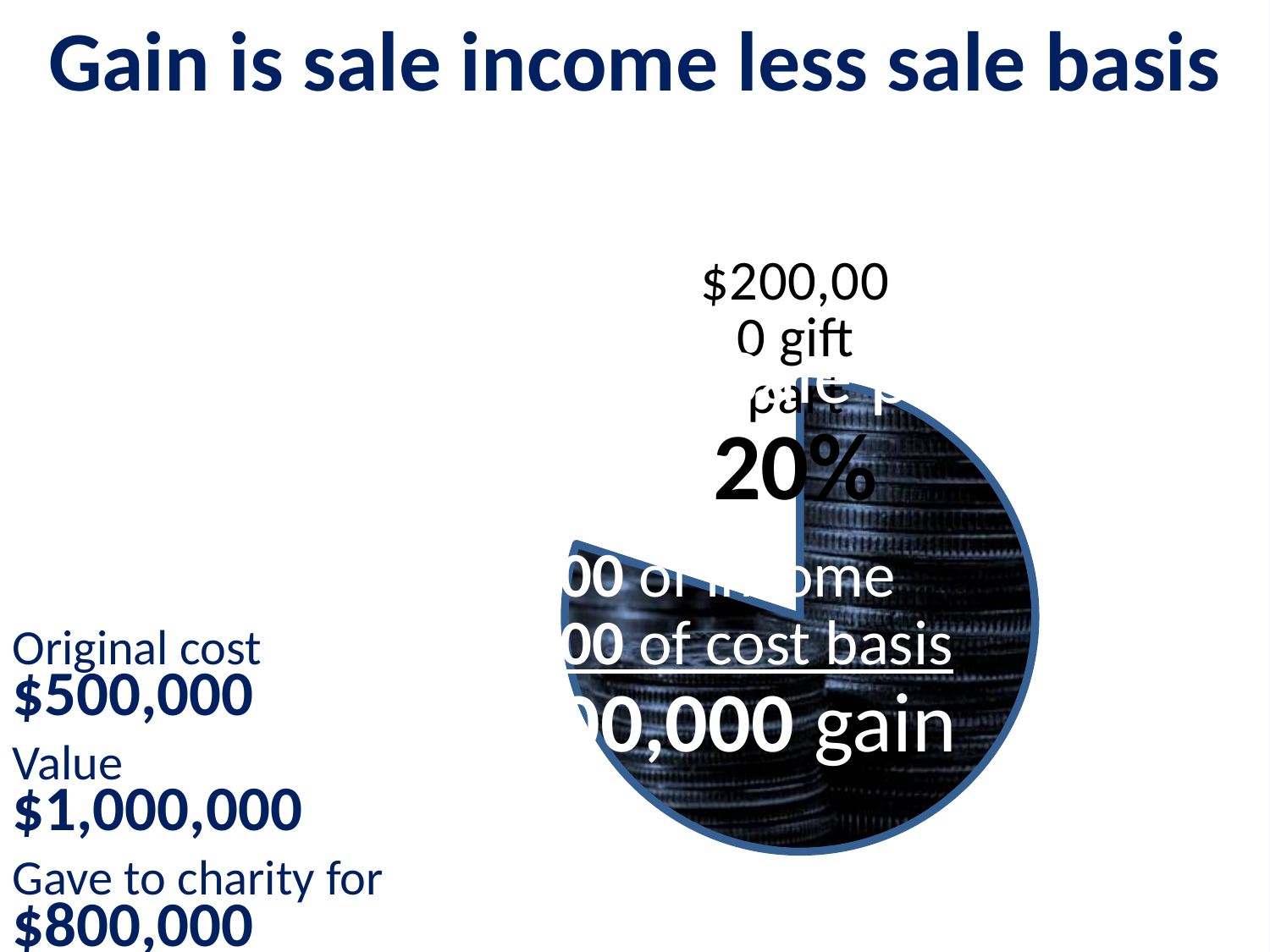
What kind of chart is shown on the slide? pie chart How many slices does the pie chart have? 2 Is the 20% slice the larger or the smaller slice of the pie? smaller What dollar amount is labelled on the gift part slice of the pie chart? $200,000 What share of the pie does the gift part slice represent? 20% What percentage label is printed in large bold text on the pie chart? 20% Is the share of the gift part slice greater or less than 50%? less